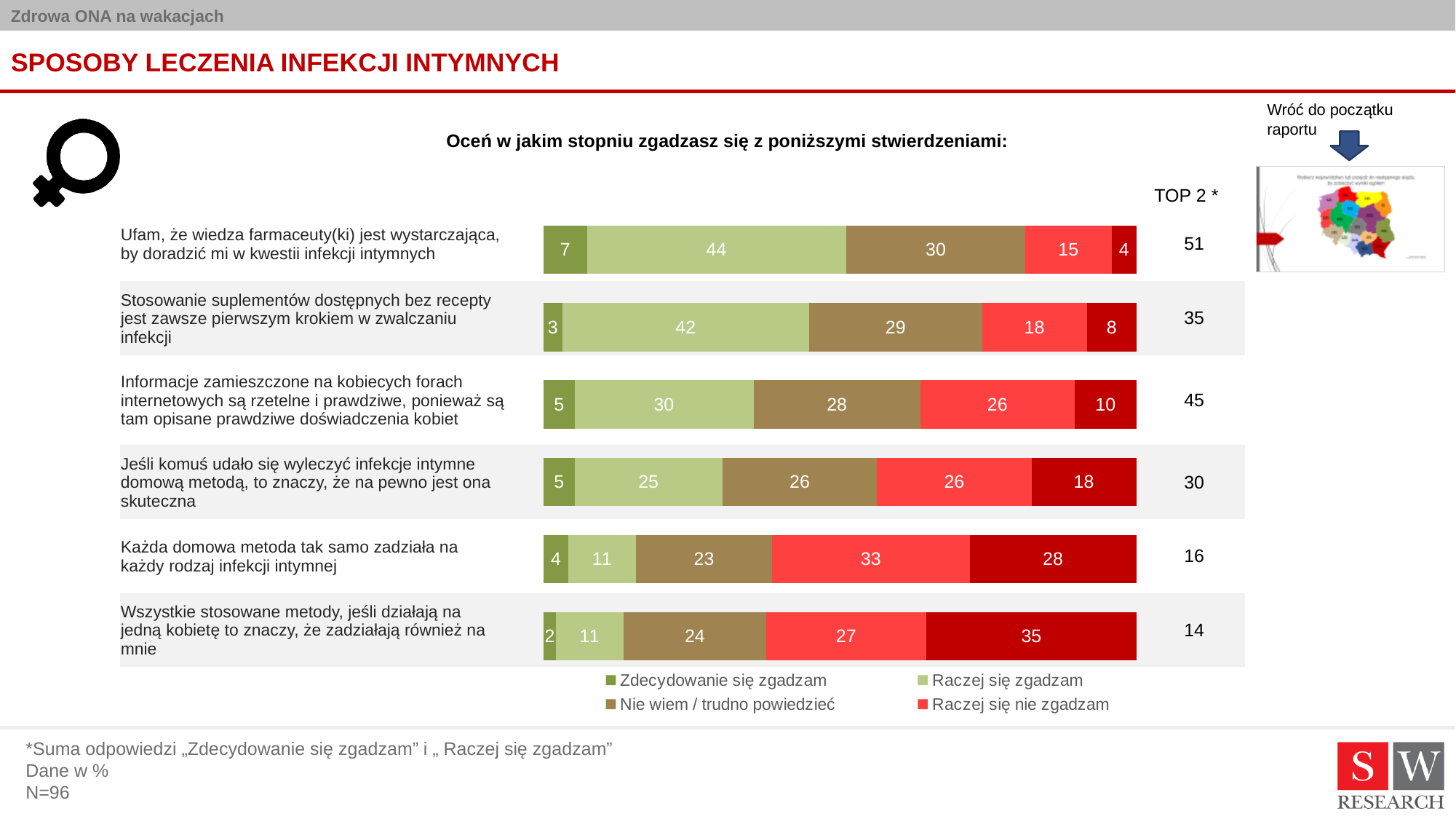
How many series does the chart legend list? 4 What is the sample size (N) stated on the slide? N=96 Which statement has the lowest TOP 2 value? Wszystkie stosowane metody, jeśli działają na jedną kobietę to znaczy, że zadziałają również na mnie What is the value of "Zdecydowanie się zgadzam" for the statement "Każda domowa metoda tak samo zadziała na każdy rodzaj infekcji intymnej"? 4 Which statement has the highest TOP 2 value? Ufam, że wiedza farmaceuty(ki) jest wystarczająca, by doradzić mi w kwestii infekcji intymnych Which statement has the larger "Raczej się nie zgadzam" value: "Każda domowa metoda tak samo zadziała na każdy rodzaj infekcji intymnej" or "Wszystkie stosowane metody, jeśli działają na jedną kobietę..."? Każda domowa metoda tak samo zadziała na każdy rodzaj infekcji intymnej What is the value of "Raczej się zgadzam" for the statement "Ufam, że wiedza farmaceuty(ki) jest wystarczająca, by doradzić mi w kwestii infekcji intymnych"? 44 What is the TOP 2 value for the statement "Informacje zamieszczone na kobiecych forach internetowych są rzetelne i prawdziwe..."? 45 How many statements (categories) are plotted in the chart? 6 What is the difference between the TOP 2 values of "Ufam, że wiedza farmaceuty(ki)..." and "Stosowanie suplementów dostępnych bez recepty..."? 16 What is the value of "Nie wiem / trudno powiedzieć" for the statement "Stosowanie suplementów dostępnych bez recepty jest zawsze pierwszym krokiem w zwalczaniu infekcji"? 29 What kind of chart is shown on the slide? Stacked bar chart